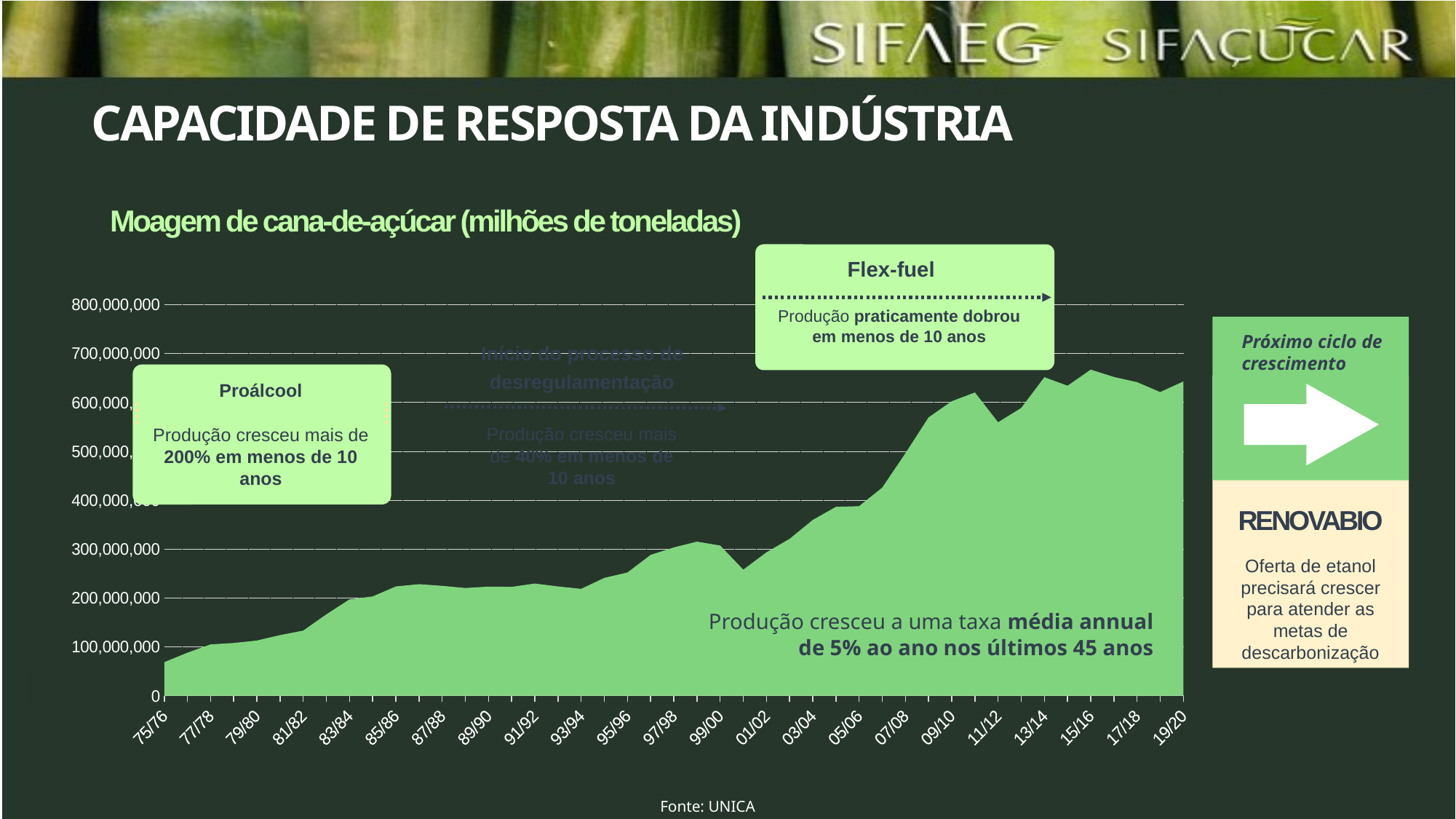
Is the value for 85/86 greater or less than 200,000,000? greater What kind of chart is shown on the slide? area chart What source is cited for the chart? UNICA Do the values generally rise or fall from 75/76 to 19/20? rise Is the value for 11/12 greater or less than 600,000,000? less How many labels are shown on the x axis of the chart? 23 Is the value for 19/20 greater or less than 600,000,000? greater Which x-axis label has the lowest value in the chart? 75/76 Which is larger, the value for 11/12 or the value for 13/14? 13/14 What is the title of the chart? Moagem de cana-de-açúcar (milhões de toneladas)